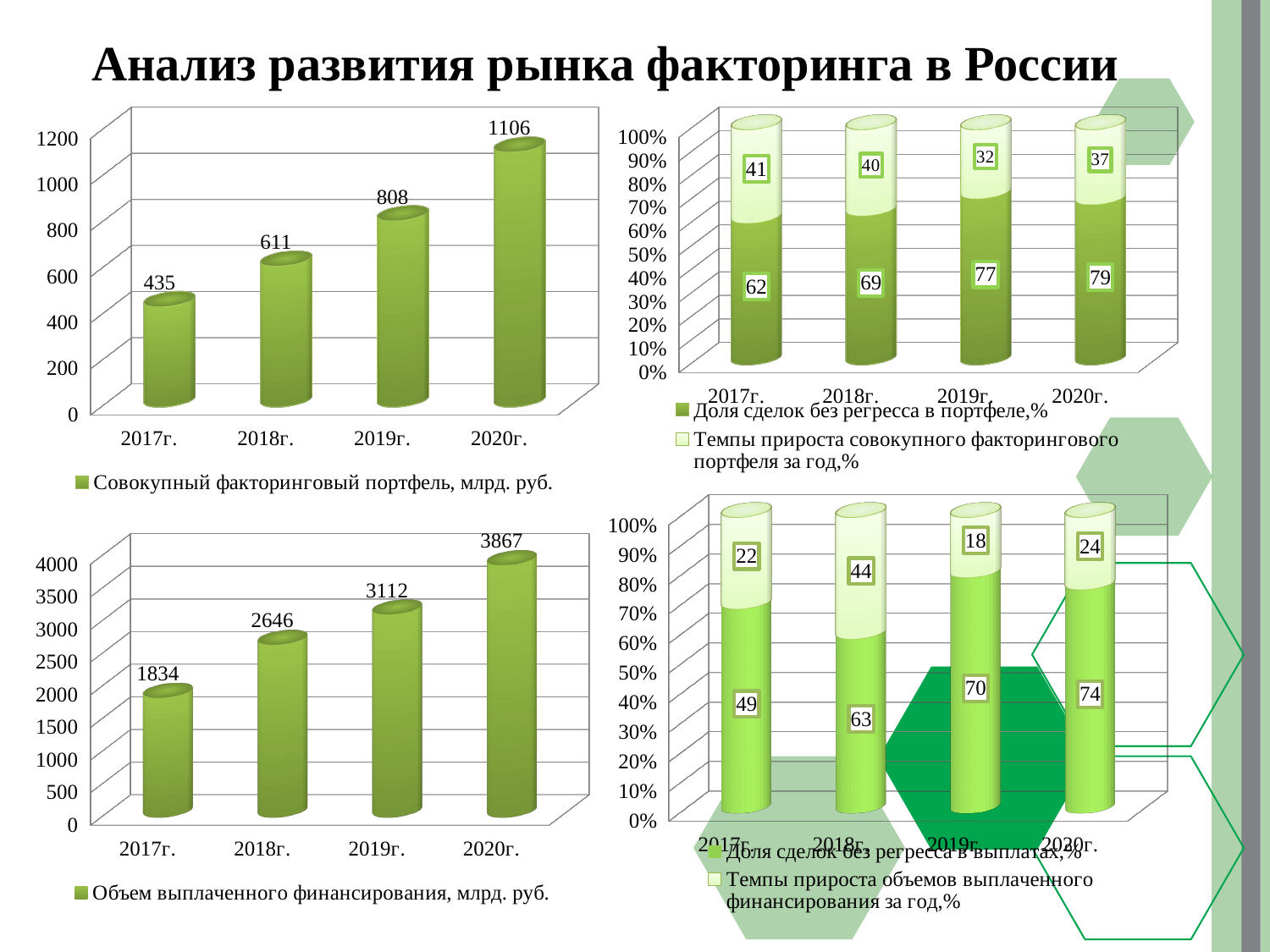
In the top-left chart (Совокупный факторинговый портфель, млрд. руб.), what is the difference between the 2020г. and 2017г. values? 671 In the top-left chart (Совокупный факторинговый портфель, млрд. руб.), do the values rise or fall from 2017г. to 2020г.? rise In the top-right stacked chart, how many series does the legend list? 2 What kind of chart is the bottom-left chart (Объем выплаченного финансирования, млрд. руб.)? bar chart In the bottom-right stacked chart, which is larger for 2017г.: 'Доля сделок без регресса в выплатах,%' or 'Темпы прироста объемов выплаченного финансирования за год,%'? Доля сделок без регресса в выплатах,% In the top-left chart (Совокупный факторинговый портфель, млрд. руб.), what is the value for 2019г.? 808 In the top-left chart (Совокупный факторинговый портфель, млрд. руб.), which year has the highest value? 2020г. In the bottom-right stacked chart, what is the value of 'Темпы прироста объемов выплаченного финансирования за год,%' for 2018г.? 44 In the bottom-left chart (Объем выплаченного финансирования, млрд. руб.), what is the value for 2018г.? 2646 In the bottom-left chart (Объем выплаченного финансирования, млрд. руб.), which year has the lowest value? 2017г. In the top-right stacked chart, what is the value of 'Доля сделок без регресса в портфеле,%' for 2019г.? 77 In the bottom-left chart (Объем выплаченного финансирования, млрд. руб.), how many years are shown on the x axis? 4